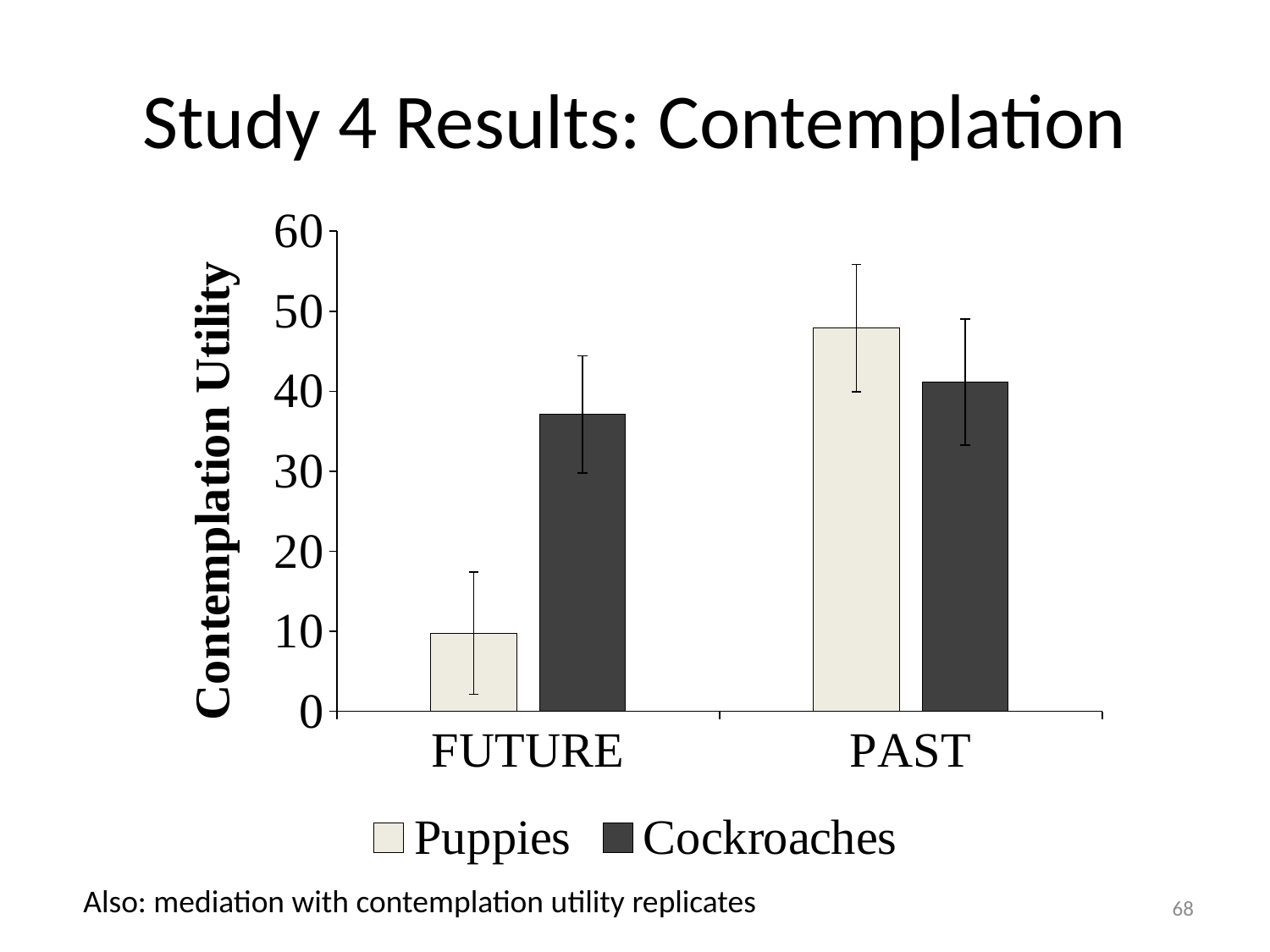
In the FUTURE condition, which series has the larger value, Puppies or Cockroaches? Cockroaches Which bar has the lowest value in the chart? Puppies in FUTURE What is the title of the y axis? Contemplation Utility Is the value for Puppies in the PAST condition greater or less than 40? greater What kind of chart is shown on the slide? bar chart How many categories are shown on the x axis? 2 Is the value for Puppies in the FUTURE condition greater or less than 20? less Is the value for Cockroaches in the PAST condition greater or less than 50? less In the PAST condition, which series has the larger value, Puppies or Cockroaches? Puppies How many series does the legend list? 2 Which bar has the highest value in the chart? Puppies in PAST